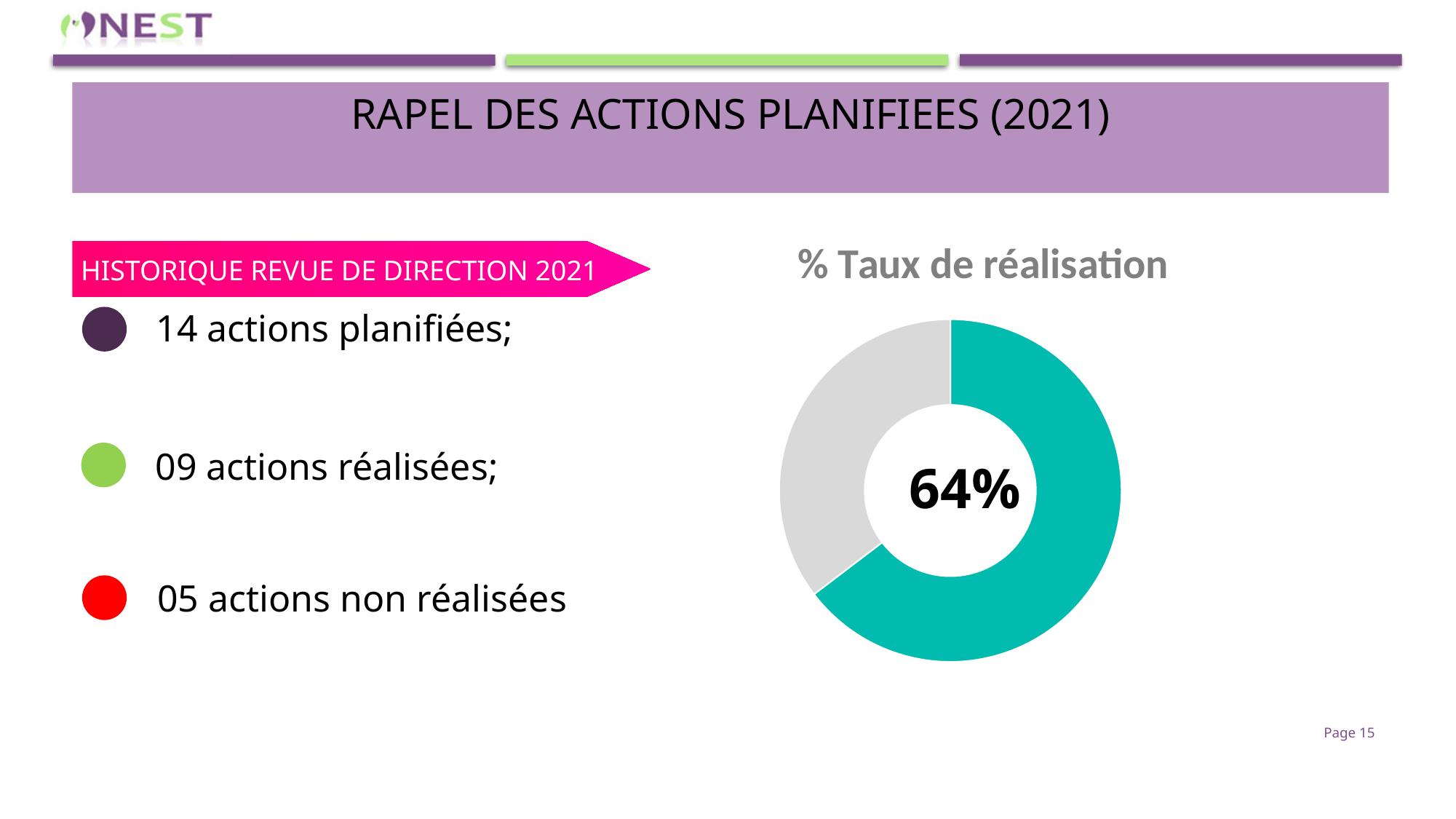
What share of the doughnut chart does the teal slice represent? 64% What percentage value is printed in the centre of the doughnut chart? 64% What colour is the largest slice of the doughnut chart? Teal What is the title of the chart on the slide? % Taux de réalisation How many slices does the doughnut chart have? 2 What kind of chart is shown on the slide? Doughnut chart Which slice of the doughnut chart is larger, the teal one or the grey one? The teal one